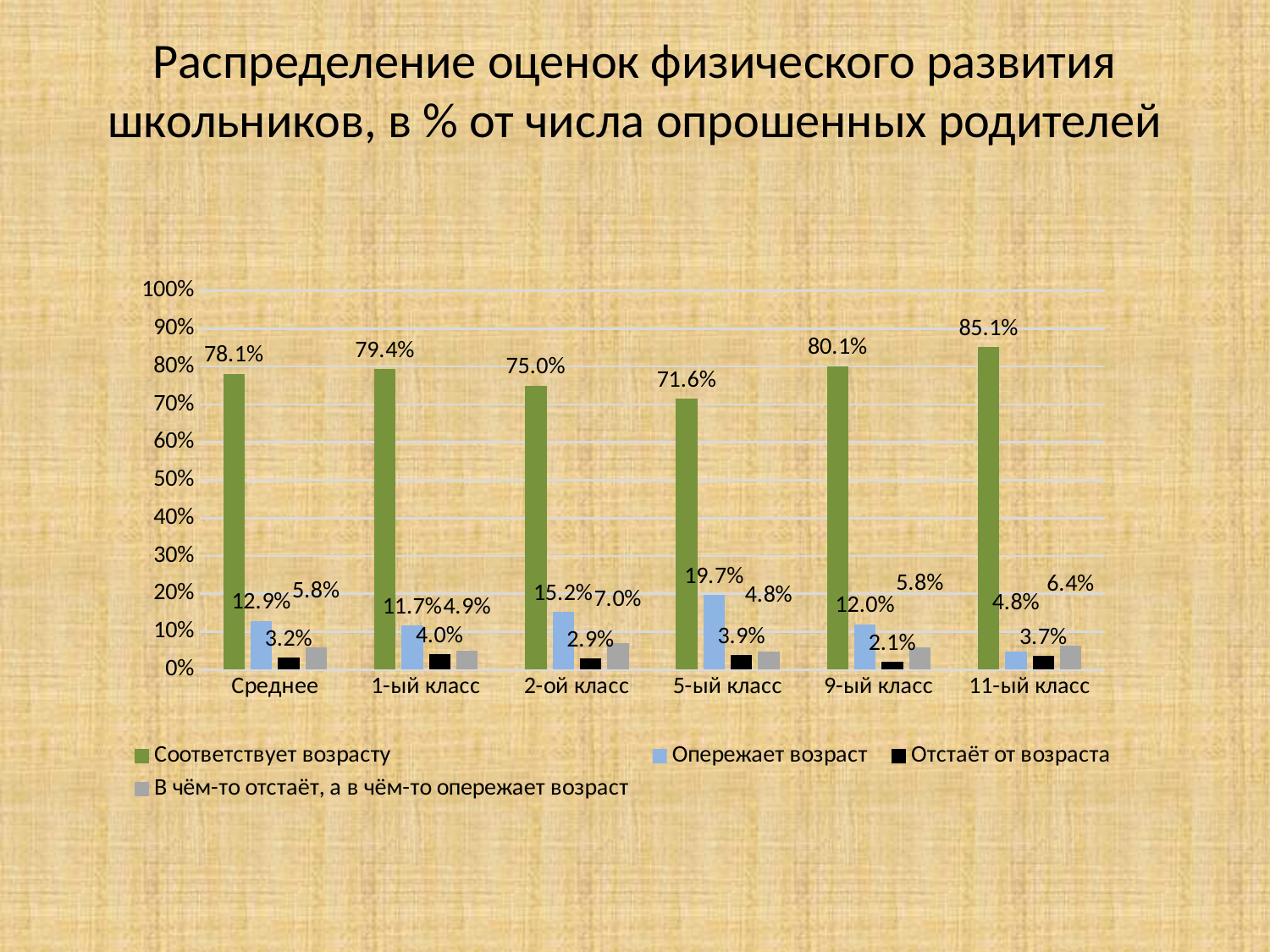
Which series is shown in green? Соответствует возрасту What kind of chart is shown on the slide? Bar chart Which category has the highest value for "Соответствует возрасту"? 11-ый класс Which is larger: the "Опережает возраст" value for 2-ой класс or for 9-ый класс? 2-ой класс What is the value of "В чём-то отстаёт, а в чём-то опережает возраст" for 2-ой класс? 7.0% What is the value of "Отстаёт от возраста" for 9-ый класс? 2.1% What is the difference between the "Соответствует возрасту" values for 11-ый класс and 5-ый класс? 13.5% How many series does the legend list? 4 What is the value of "Опережает возраст" for 5-ый класс? 19.7% What is the value of "Соответствует возрасту" for 11-ый класс? 85.1% How many categories are shown on the x axis? 6 Which category has the lowest value for "Соответствует возрасту"? 5-ый класс